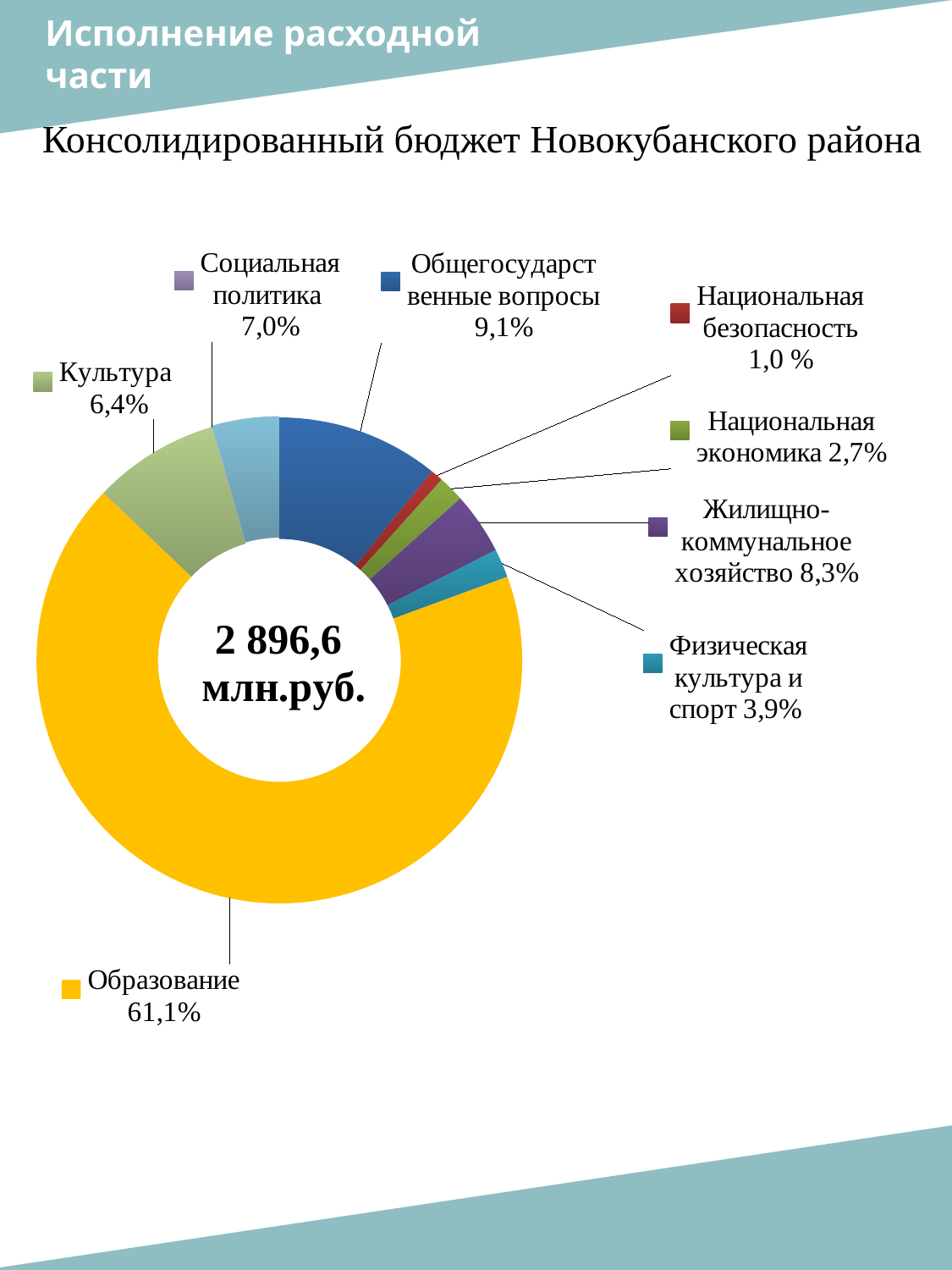
How many categories are shown in the chart? 8 Which category has the smallest share of the chart? Национальная безопасность What is the value shown for Жилищно-коммунальное хозяйство? 8,3% What kind of chart is shown on the slide? Doughnut (pie) chart What share of the chart does Образование account for? 61,1% What total amount is printed in the centre of the chart? 2 896,6 млн.руб. What is the difference between the shares of Социальная политика and Культура? 0,6% Which is larger, the share of Общегосударственные вопросы or the share of Жилищно-коммунальное хозяйство? Общегосударственные вопросы What is the value shown for Общегосударственные вопросы? 9,1% What is the value shown for Национальная экономика? 2,7% What is the value shown for Физическая культура и спорт? 3,9% Which category has the largest share of the chart? Образование